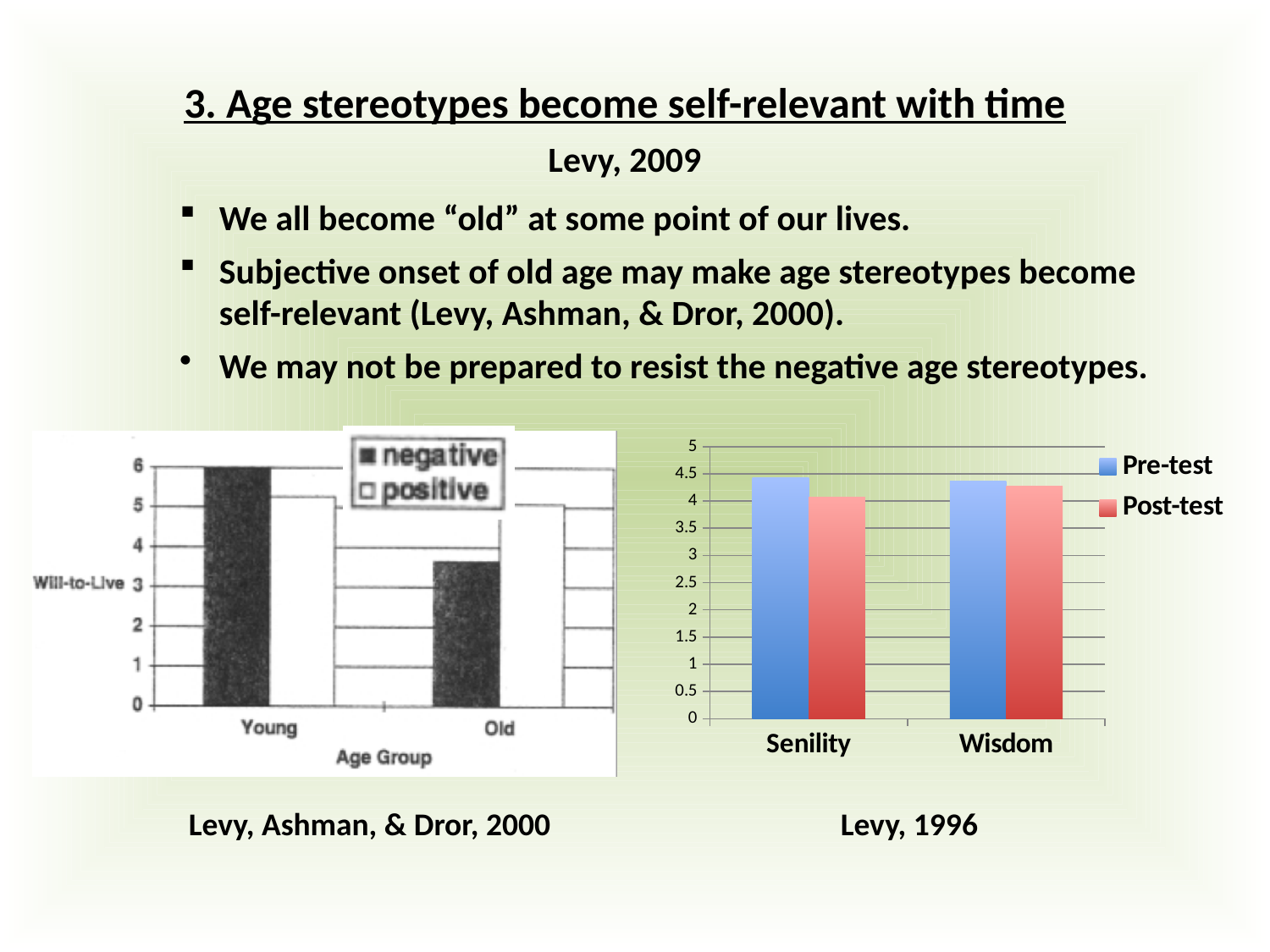
What kind of chart is the right chart (Levy, 1996)? bar chart In the left chart (Levy, Ashman, & Dror, 2000), how many age groups are shown on the x axis? 2 In the left chart (Levy, Ashman, & Dror, 2000), does the negative series rise or fall from Young to Old? fall In the right chart (Levy, 1996), what colour are the Post-test bars? red In the right chart (Levy, 1996), which is larger for Senility: Pre-test or Post-test? Pre-test In the left chart (Levy, Ashman, & Dror, 2000), is the negative bar for the Old age group greater or less than 4? less In the right chart (Levy, 1996), is the Pre-test value for Senility greater or less than 4? greater In the left chart (Levy, Ashman, & Dror, 2000), which is larger for the Old age group: the negative bar or the positive bar? positive In the left chart (Levy, Ashman, & Dror, 2000), how many series does the legend list? 2 What kind of chart is the left chart (Levy, Ashman, & Dror, 2000)? bar chart In the left chart (Levy, Ashman, & Dror, 2000), what is the label on the vertical axis? Will-to-Live In the right chart (Levy, 1996), how many series does the legend list? 2